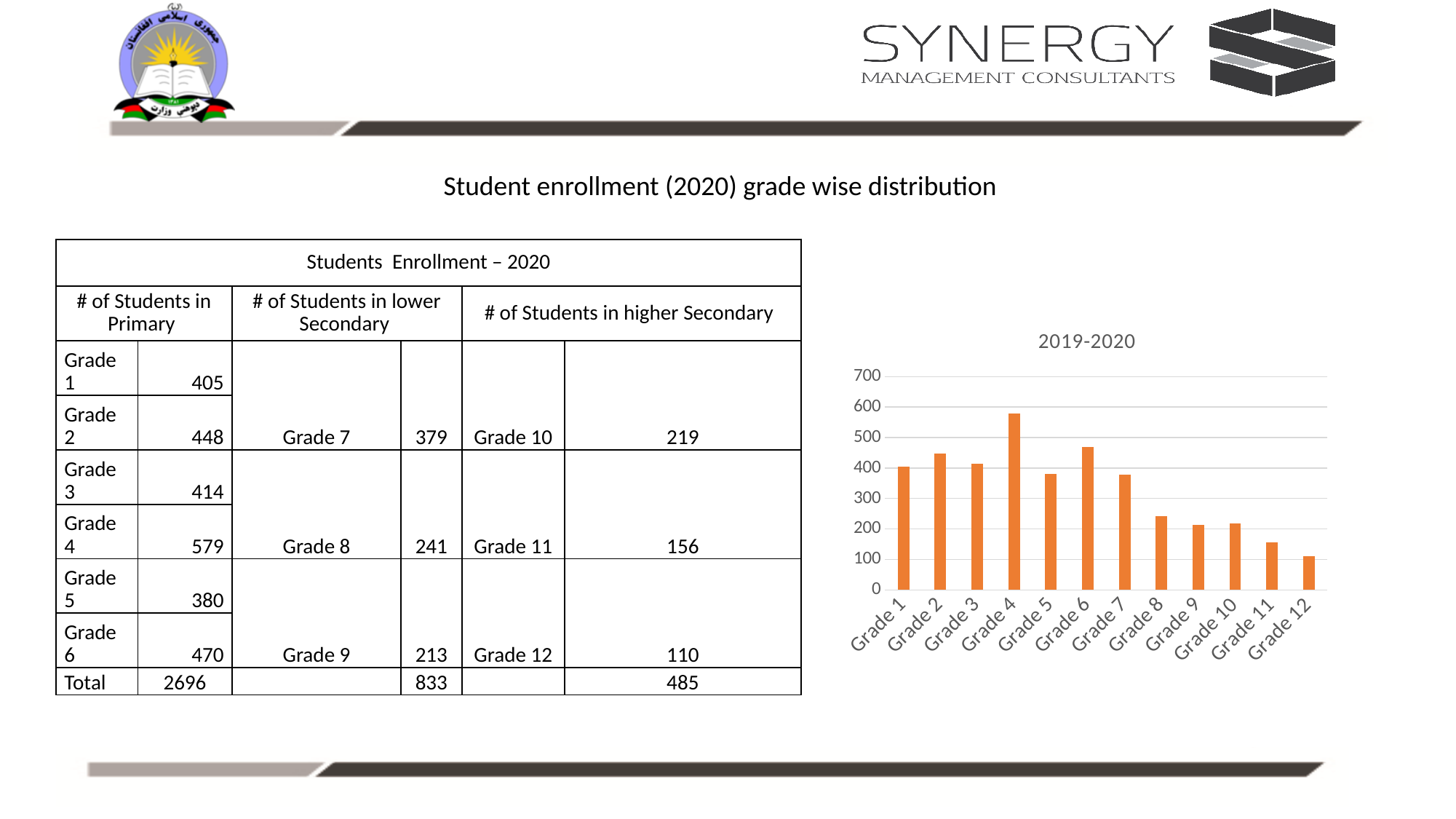
What is the title of the chart? 2019-2020 Do the bars generally rise or fall from Grade 7 to Grade 12? fall What type of chart is shown on the slide? bar chart What is the enrollment value for Grade 4 shown on the slide? 579 How many grades are plotted on the x axis of the chart? 12 Is the value for Grade 8 greater or less than 300? less What is the difference between the Grade 10 and Grade 12 enrollment values shown on the slide? 109 Is the value for Grade 12 greater or less than 200? less Is the value for Grade 4 greater or less than 500? greater Which grade has the highest bar in the chart? Grade 4 Which is larger in the chart, Grade 6 or Grade 7? Grade 6 Which grade has the lowest bar in the chart? Grade 12